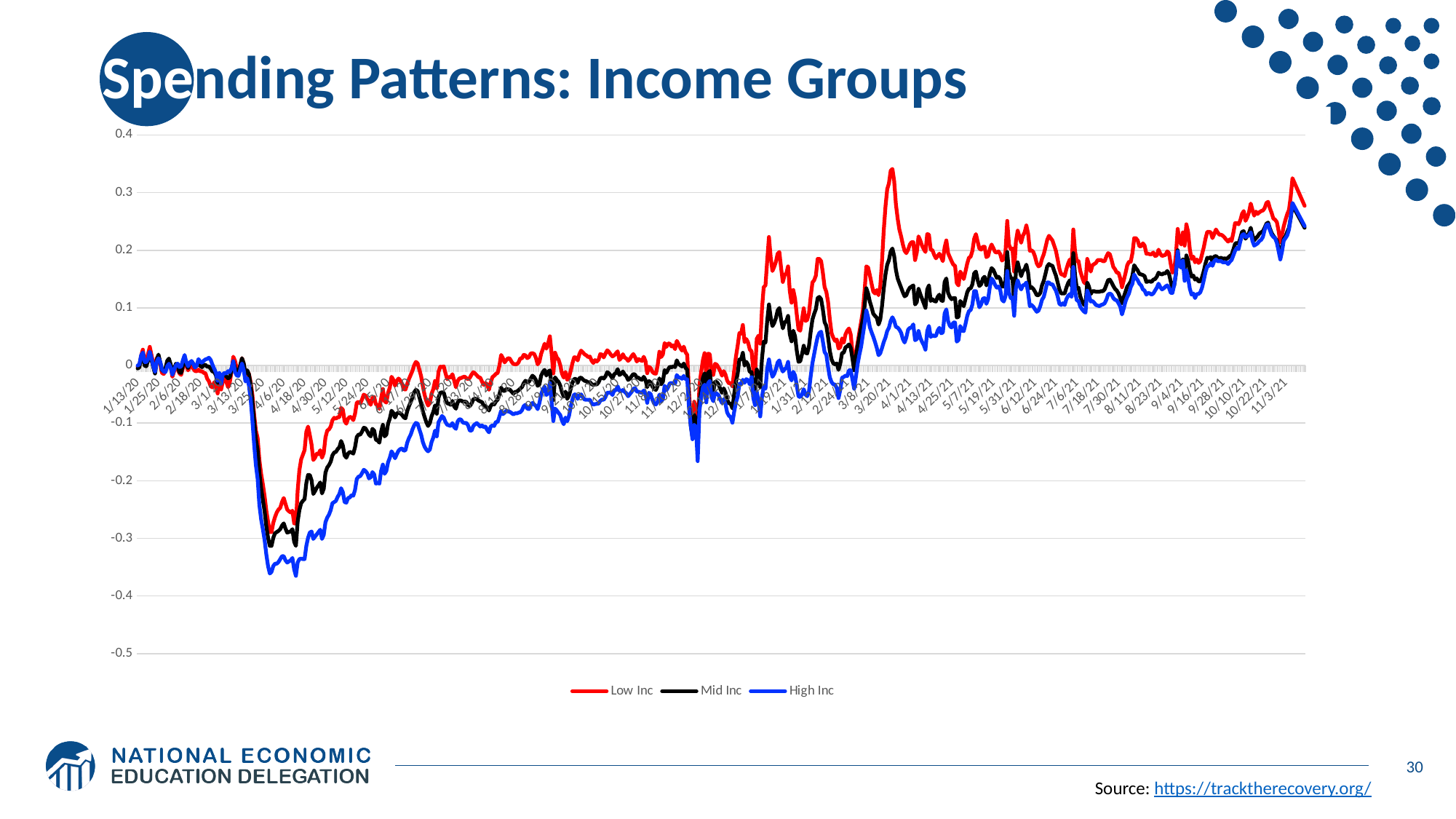
What colour is the line for the High Inc series? Blue What are the three series named in the legend? Low Inc, Mid Inc, High Inc Is the peak value for Low Inc around 3/20/21 greater or less than 0.3? greater Is the value for High Inc around 4/13/21 greater or less than 0.1? less Around 4/6/20, which is larger: the value for Low Inc or the value for High Inc? Low Inc Is the value for High Inc at the end of the series (around 11/3/21) greater or less than 0.2? greater Do the values for Mid Inc generally rise or fall from 4/6/20 to 11/3/21? Rise Which series falls to the lowest value during the dip in spring 2020 (around 4/6/20)? High Inc How many series does the legend list? 3 What kind of chart is shown on the slide? Line chart Which series reaches the highest value around 3/20/21? Low Inc